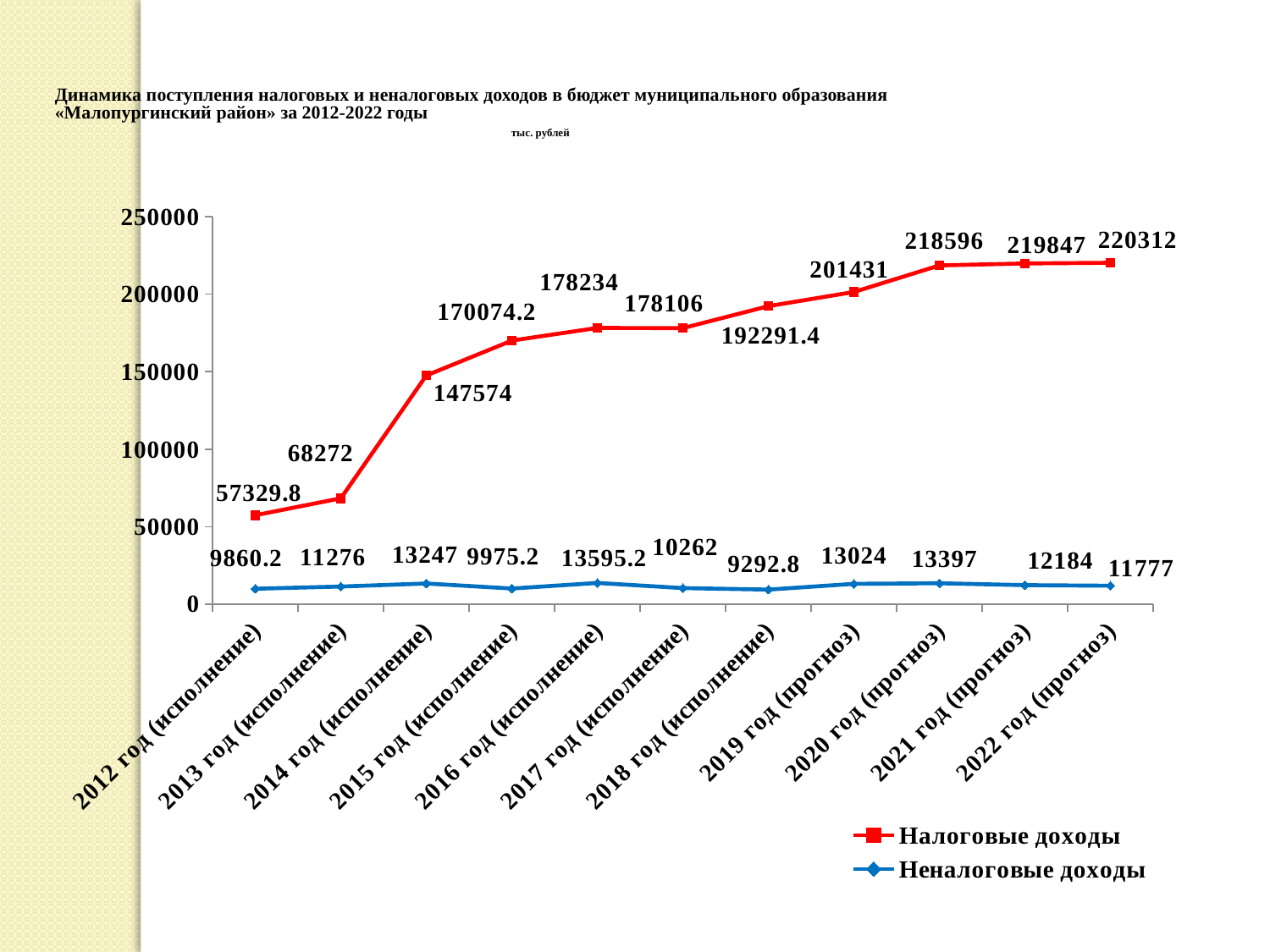
Which is larger: Неналоговые доходы in 2021 год (прогноз) or in 2022 год (прогноз)? 2021 год (прогноз) Does the Налоговые доходы series generally rise or fall from 2012 to 2022? rise What is the value of Налоговые доходы for 2022 год (прогноз)? 220312 Which year has the highest value of Налоговые доходы? 2022 год (прогноз) What is the value of Налоговые доходы for 2012 год (исполнение)? 57329.8 Which year has the lowest value of Неналоговые доходы? 2018 год (исполнение) What is the value of Неналоговые доходы for 2016 год (исполнение)? 13595.2 Is the value of Налоговые доходы for 2019 год (прогноз) greater or less than 200000? greater What kind of chart is shown on the slide? line chart How many years are shown on the x axis? 11 How many series does the legend list? 2 What is the difference between Налоговые доходы in 2014 год (исполнение) and 2013 год (исполнение)? 79302